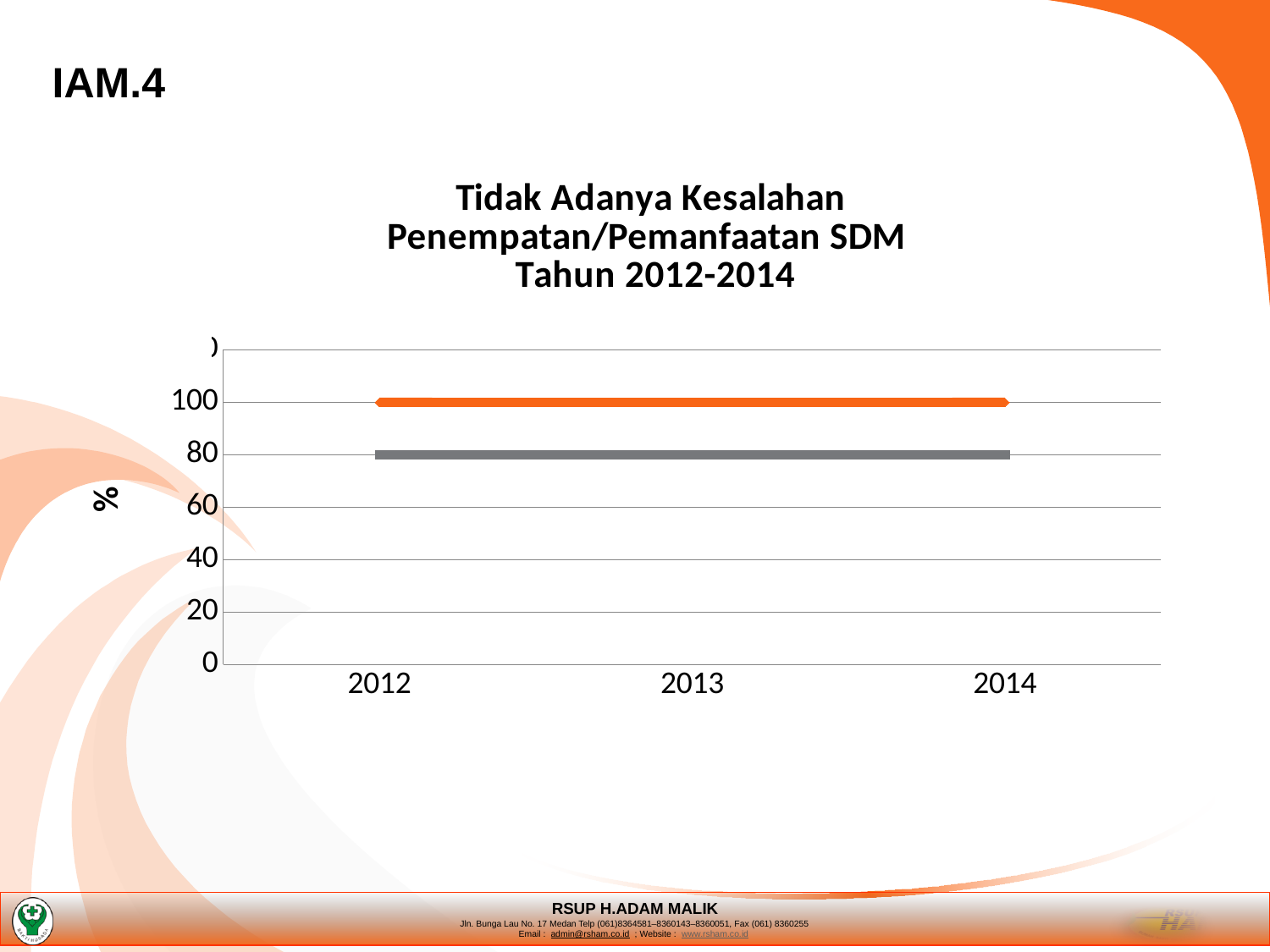
What is the title of the chart? Tidak Adanya Kesalahan Penempatan/Pemanfaatan SDM Tahun 2012-2014 Which year is the first category on the x axis? 2012 What label is shown on the y axis of the chart? % Is the value of the gray line in 2013 greater or less than 100? less How many years are shown on the x axis of the chart? 3 Does the orange line rise, fall or stay flat from 2012 to 2014? stays flat Is the value of the orange line in 2012 greater or less than 60? greater What kind of chart is shown on the slide? line chart What value does the gray line show for 2012? 80 In 2014, which line is higher, the orange line or the gray line? orange line